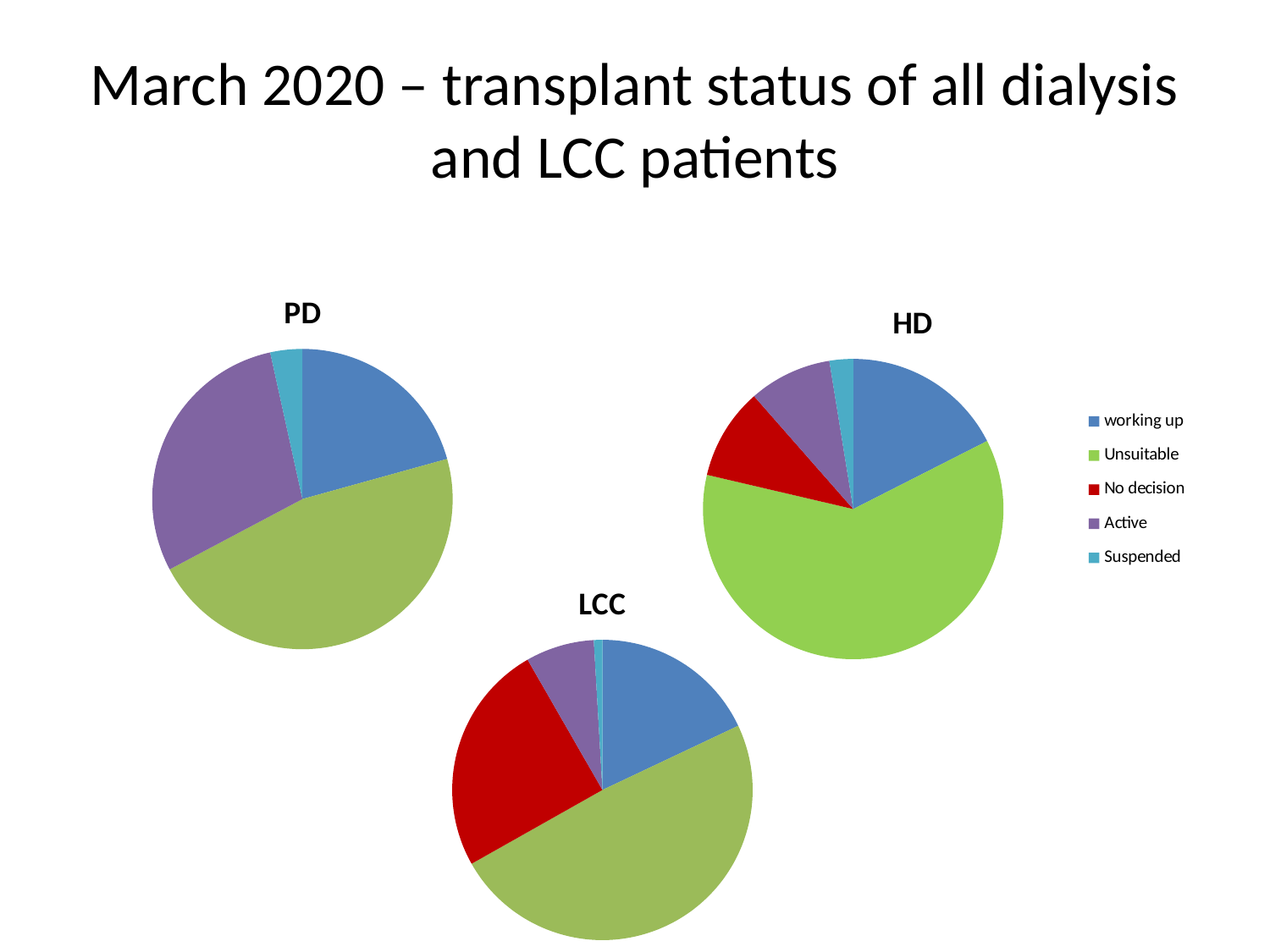
In the HD pie chart, which category has the smallest slice? Suspended How many pie charts are shown on the slide? 3 In the LCC pie chart, which category has the largest slice? Unsuitable In the HD pie chart, which category has the largest slice? Unsuitable In the PD pie chart, which category has the largest slice? Unsuitable In the LCC pie chart, which slice is larger: No decision or Active? No decision How many categories does the legend list? 5 In the PD pie chart, which category has the smallest slice? Suspended In the HD pie chart, which slice is larger: working up or No decision? working up In the PD pie chart, which slice is larger: Active or working up? Active In the LCC pie chart, which category has the smallest slice? Suspended What kind of chart is used for the PD, HD and LCC data on this slide? pie chart